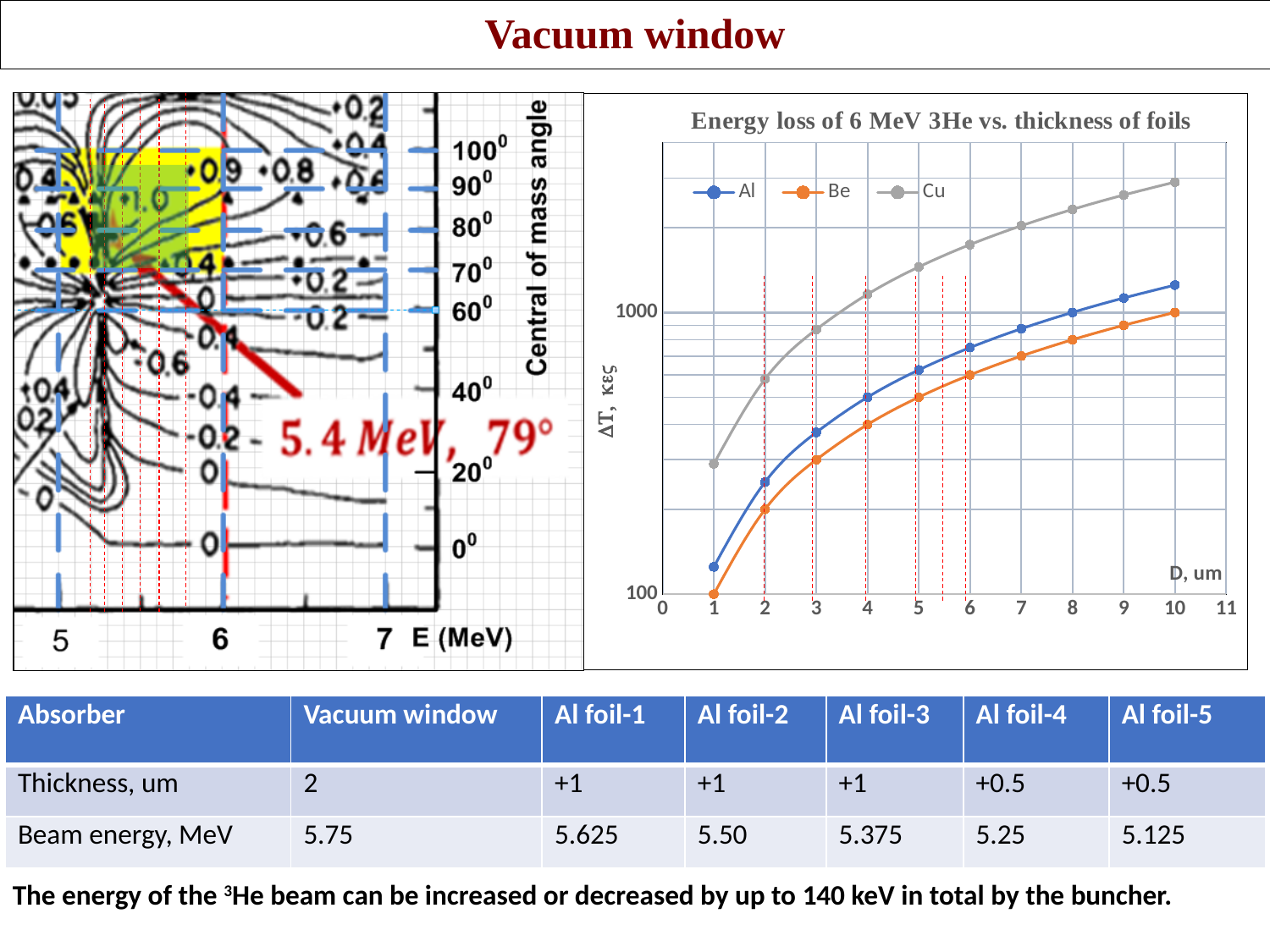
In the 'Energy loss of 6 MeV 3He vs. thickness of foils' chart, is the Al value at D = 5 greater or less than 1000? less In the 'Energy loss of 6 MeV 3He vs. thickness of foils' chart, is the Cu value at D = 6 greater or less than 1000? greater In the 'Energy loss of 6 MeV 3He vs. thickness of foils' chart, which series has the highest energy loss at D = 10? Cu In the 'Energy loss of 6 MeV 3He vs. thickness of foils' chart, which is larger at D = 5, the Al value or the Be value? Al What kind of chart is the 'Energy loss of 6 MeV 3He vs. thickness of foils' chart? line chart In the 'Energy loss of 6 MeV 3He vs. thickness of foils' chart, do the energy loss values rise or fall as the thickness D increases? rise In the 'Energy loss of 6 MeV 3He vs. thickness of foils' chart, how many data points does the Al series have? 10 In the 'Energy loss of 6 MeV 3He vs. thickness of foils' chart, which series has the lowest energy loss at D = 10? Be How many series does the legend of the 'Energy loss of 6 MeV 3He vs. thickness of foils' chart list? 3 What are the legend entries in the 'Energy loss of 6 MeV 3He vs. thickness of foils' chart? Al, Be, Cu In the 'Energy loss of 6 MeV 3He vs. thickness of foils' chart, is the Cu value at D = 2 greater or less than 1000? less What is the x-axis label of the 'Energy loss of 6 MeV 3He vs. thickness of foils' chart? D, um